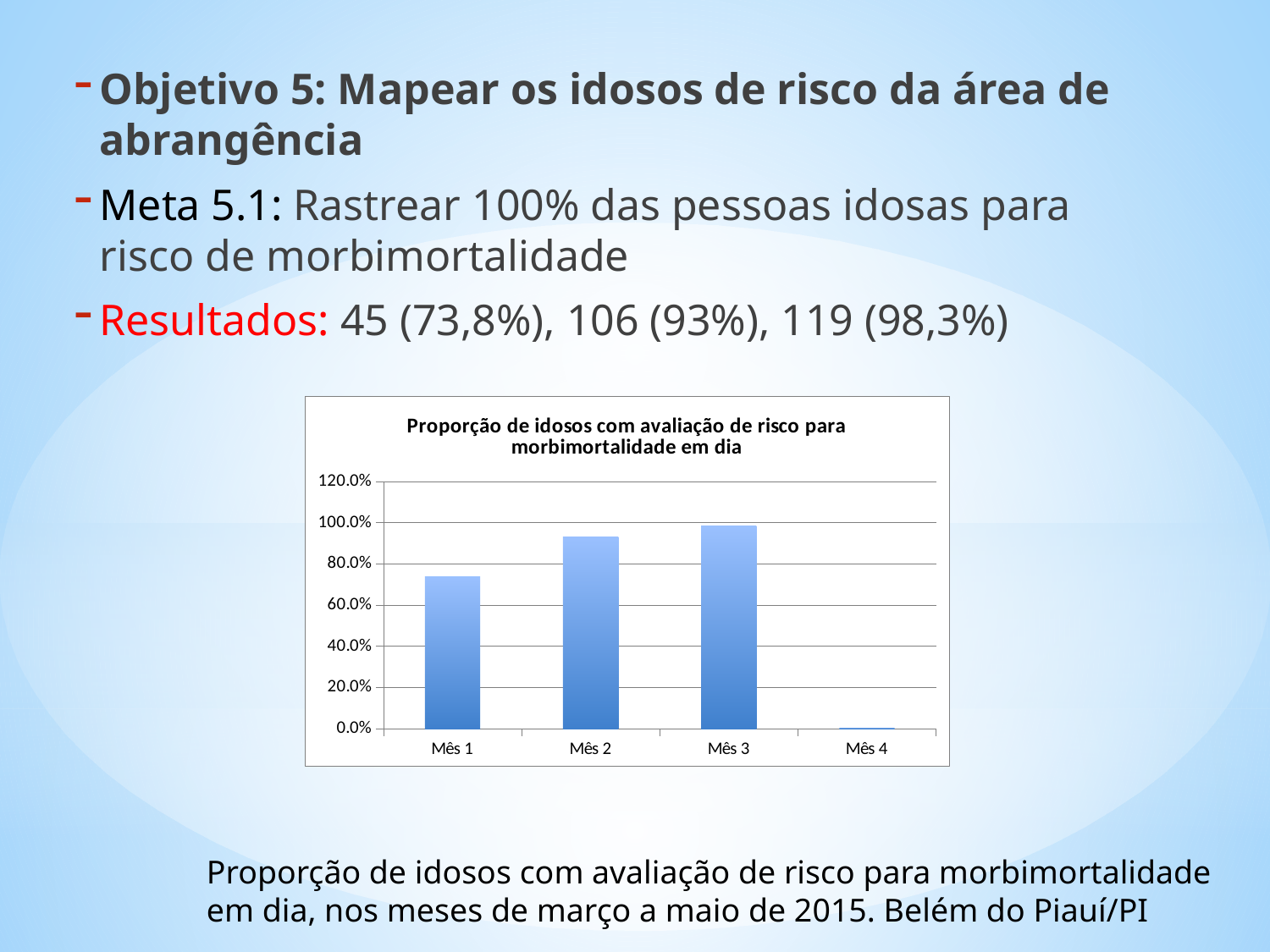
Which month has the highest bar in the chart? Mês 3 Is the value for Mês 1 greater or less than 60.0%? greater Is the value for Mês 1 greater or less than 80.0%? less Is the value for Mês 2 greater or less than 80.0%? greater Which month has the lowest bar in the chart? Mês 4 Which is larger in the chart, the value for Mês 1 or the value for Mês 2? Mês 2 Which is larger in the chart, the value for Mês 2 or the value for Mês 4? Mês 2 How many categories (months) are shown on the x axis of the chart? 4 What kind of chart is shown on the slide? bar chart What is the title of the chart? Proporção de idosos com avaliação de risco para morbimortalidade em dia Do the values rise or fall from Mês 1 to Mês 3? rise